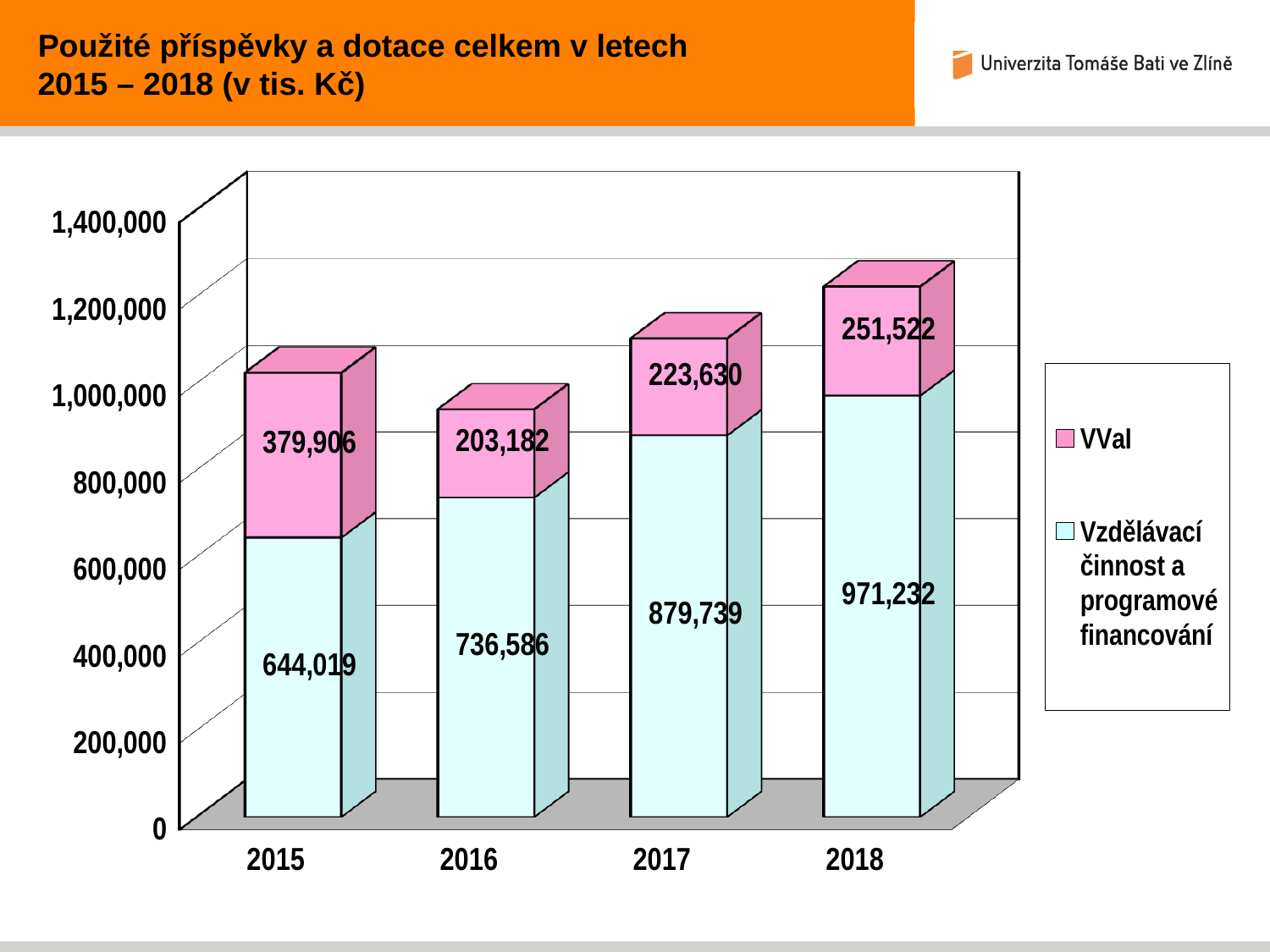
How many series does the legend list? 2 What is the difference between the VVaI values for 2015 and 2016? 176,724 How many years are shown on the x axis? 4 What is the value of VVaI for 2017? 223,630 Which is larger: the Vzdělávací činnost a programové financování value for 2016 or for 2017? 2017 What is the value of Vzdělávací činnost a programové financování for 2018? 971,232 What is the total of the stacked bar for 2018? 1,222,754 What is the total of the stacked bar for 2016? 939,768 In which year is the Vzdělávací činnost a programové financování value the highest? 2018 In which year is the VVaI value the lowest? 2016 What kind of chart is shown on the slide? Stacked bar chart What is the value of VVaI for 2015? 379,906